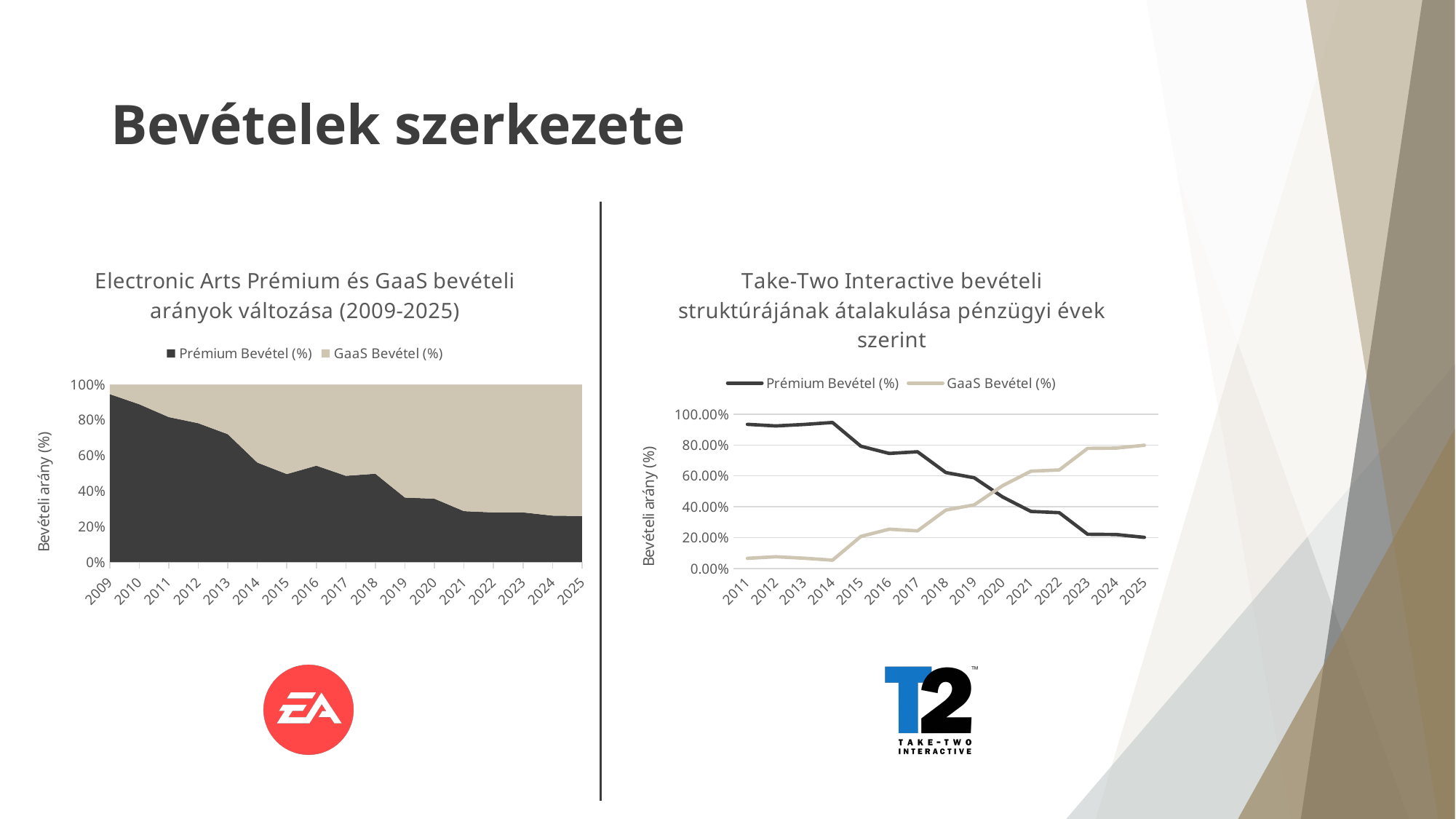
In the Electronic Arts chart, is the Prémium Bevétel (%) value for 2025 greater or less than 40%? less What is the y-axis label of the Take-Two Interactive chart? Bevételi arány (%) In the Electronic Arts chart, does the Prémium Bevétel (%) share rise or fall from 2009 to 2025? fall How many years are shown on the x axis of the Electronic Arts chart? 17 In the Take-Two Interactive chart, is the GaaS Bevétel (%) value for 2011 greater or less than 20.00%? less What kind of chart is the Electronic Arts chart on the left? area chart How many series does the legend of the Electronic Arts chart list? 2 In the Electronic Arts chart, is the Prémium Bevétel (%) value for 2009 greater or less than 80%? greater What kind of chart is the Take-Two Interactive chart on the right? line chart In the Take-Two Interactive chart, which series has the larger value in 2025, Prémium Bevétel (%) or GaaS Bevétel (%)? GaaS Bevétel (%) In the Take-Two Interactive chart, does the GaaS Bevétel (%) line rise or fall from 2011 to 2025? rise How many years are shown on the x axis of the Take-Two Interactive chart? 15